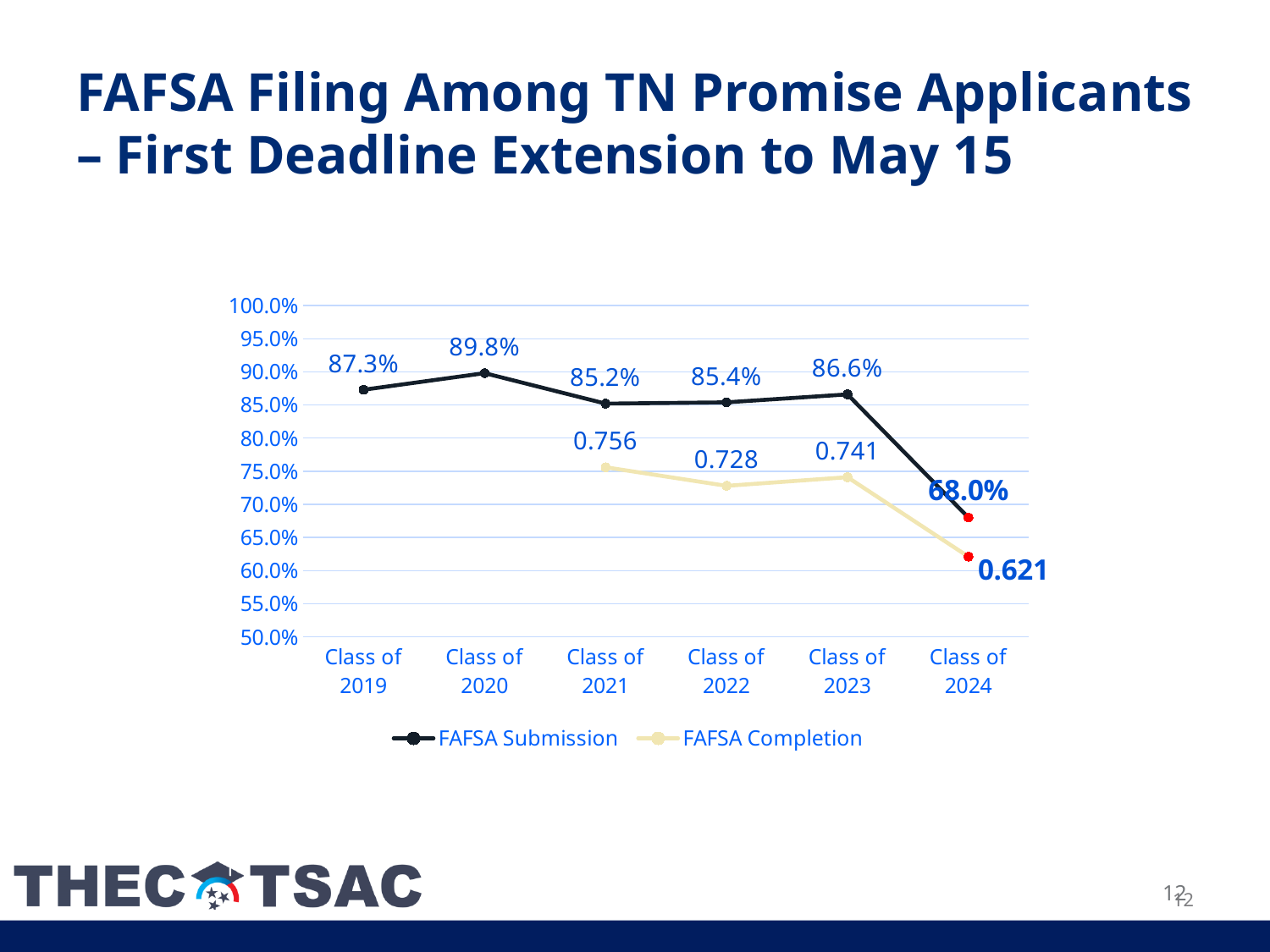
Which is larger, the FAFSA Submission value for the Class of 2019 or for the Class of 2021? Class of 2019 Does the FAFSA Completion series rise or fall from the Class of 2023 to the Class of 2024? Fall How many classes are shown on the x axis? 6 What is the FAFSA Submission value for the Class of 2020? 89.8% What is the title of the chart on the slide? FAFSA Filing Among TN Promise Applicants – First Deadline Extension to May 15 How many series does the legend list? 2 What is the FAFSA Submission value for the Class of 2024? 68.0% Which class has the lowest FAFSA Completion value? Class of 2024 Which class has the highest FAFSA Submission value? Class of 2020 What kind of chart is shown on the slide? Line chart What is the difference between the FAFSA Submission values for the Class of 2023 and the Class of 2024? 18.6% What is the FAFSA Completion value for the Class of 2022? 0.728